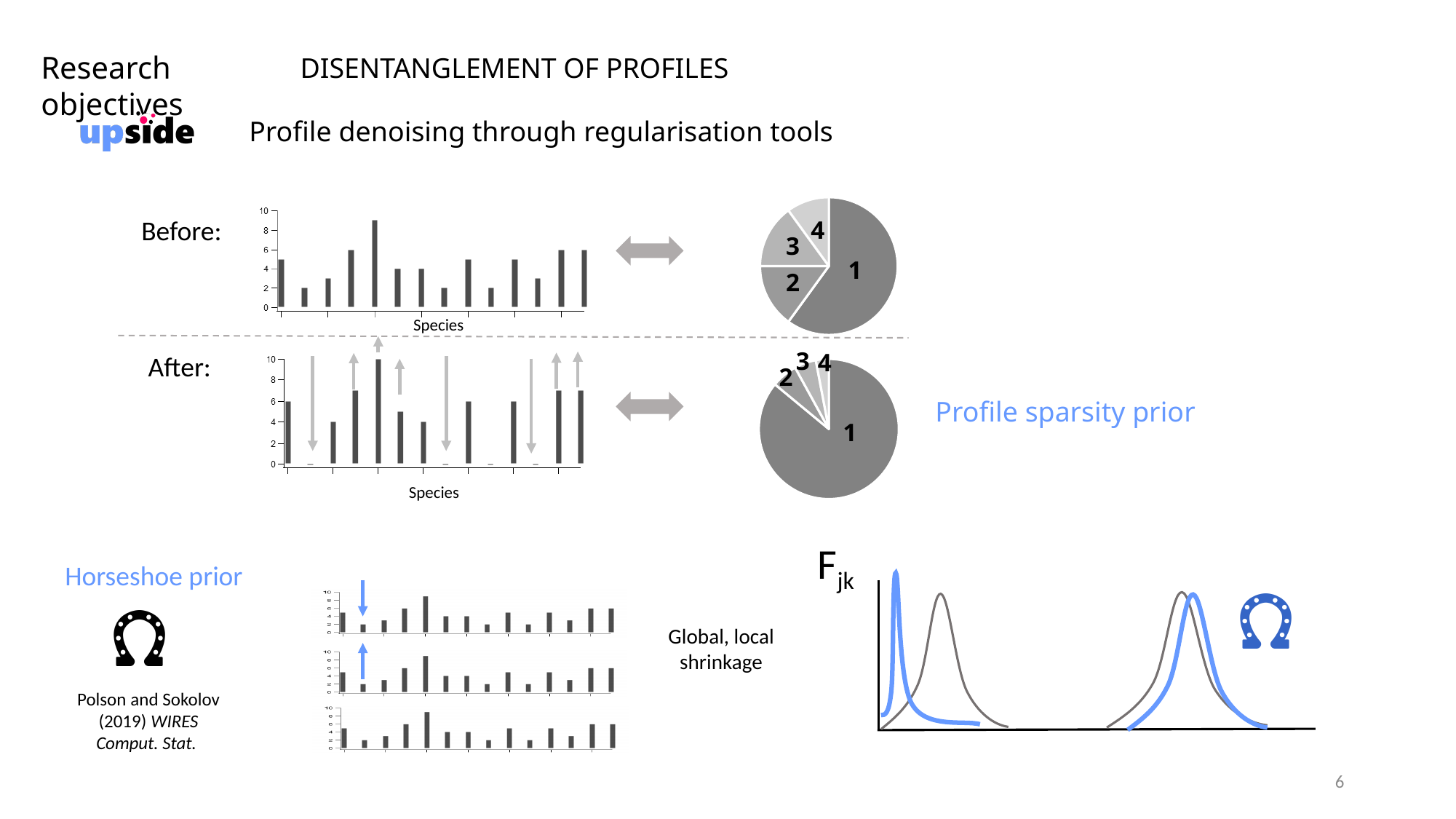
What kind of chart is shown to the right of the 'Before' bar chart? pie chart What kind of chart is the 'Before' chart on the left of the slide? bar chart What is the maximum value shown on the y-axis of the 'After' bar chart? 10 Which slice is the largest in the 'After' pie chart? 1 What is the x-axis label of the 'Before' bar chart? Species In the 'After' bar chart, is the tallest bar greater or less than 8? greater How many bars are there in the 'Before' bar chart? 14 How many slices does the 'Before' pie chart have? 4 What kind of chart is the plot labelled F_jk at the bottom right of the slide? line chart In the 'After' pie chart, which is larger, slice 1 or slice 2? 1 Which slice is the largest in the 'Before' pie chart? 1 In the 'Before' bar chart, is the tallest bar greater or less than 8? greater